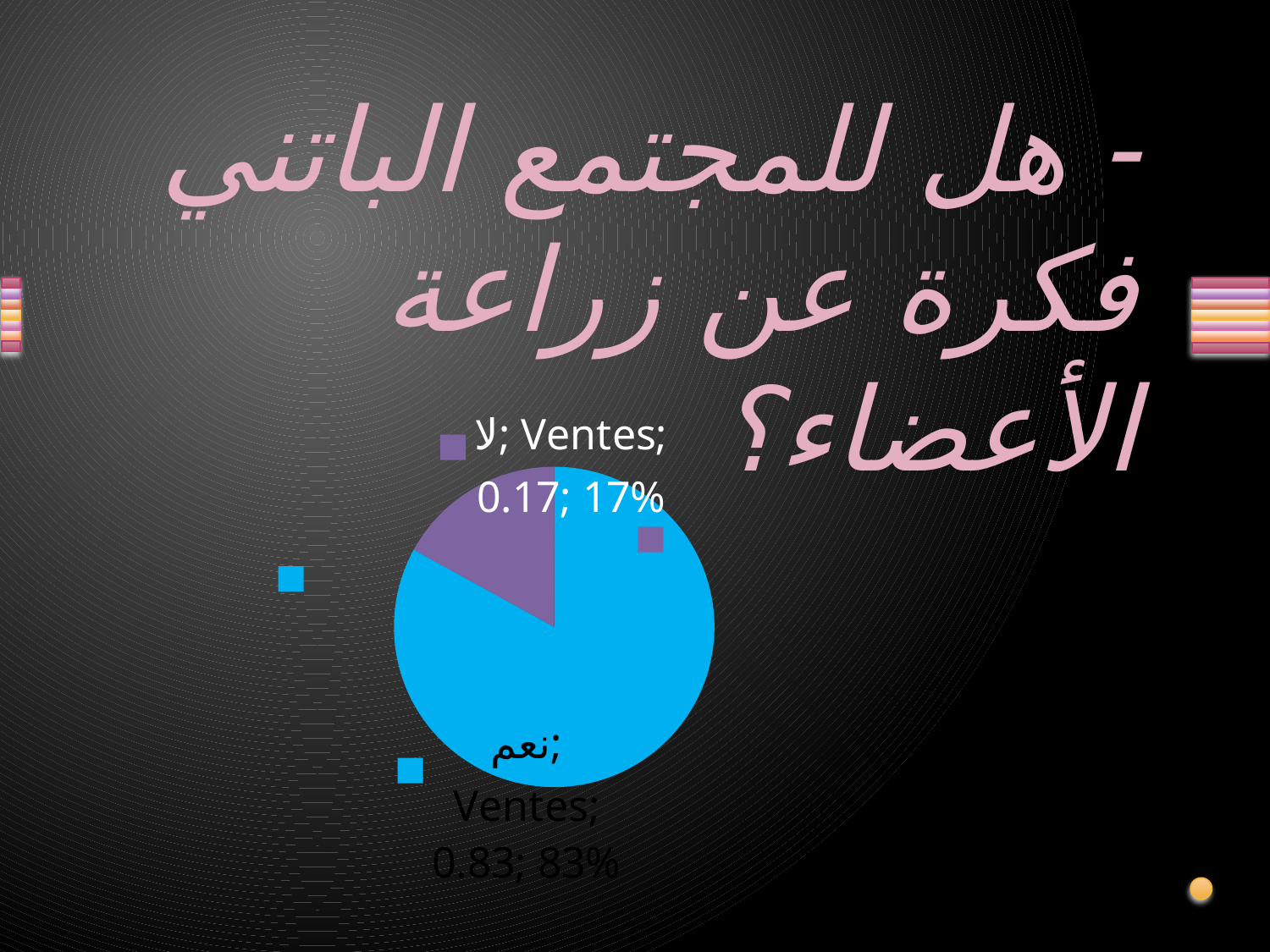
What percentage is shown for the "نعم" slice? 83% Which slice is the largest in the pie chart? نعم How many slices does the pie chart have? 2 What series name is printed in the data labels of the pie chart? Ventes Which slice is the smallest in the pie chart? لا What is the difference in percentage points between the "نعم" slice and the "لا" slice? 66 What colour is the "نعم" slice of the pie chart? blue What value is printed for the "لا" slice before the percentage? 0.17 What kind of chart is shown on the slide? pie chart Which is larger, the "نعم" slice or the "لا" slice? نعم What value is printed for the "نعم" slice before the percentage? 0.83 What percentage is shown for the "لا" slice? 17%